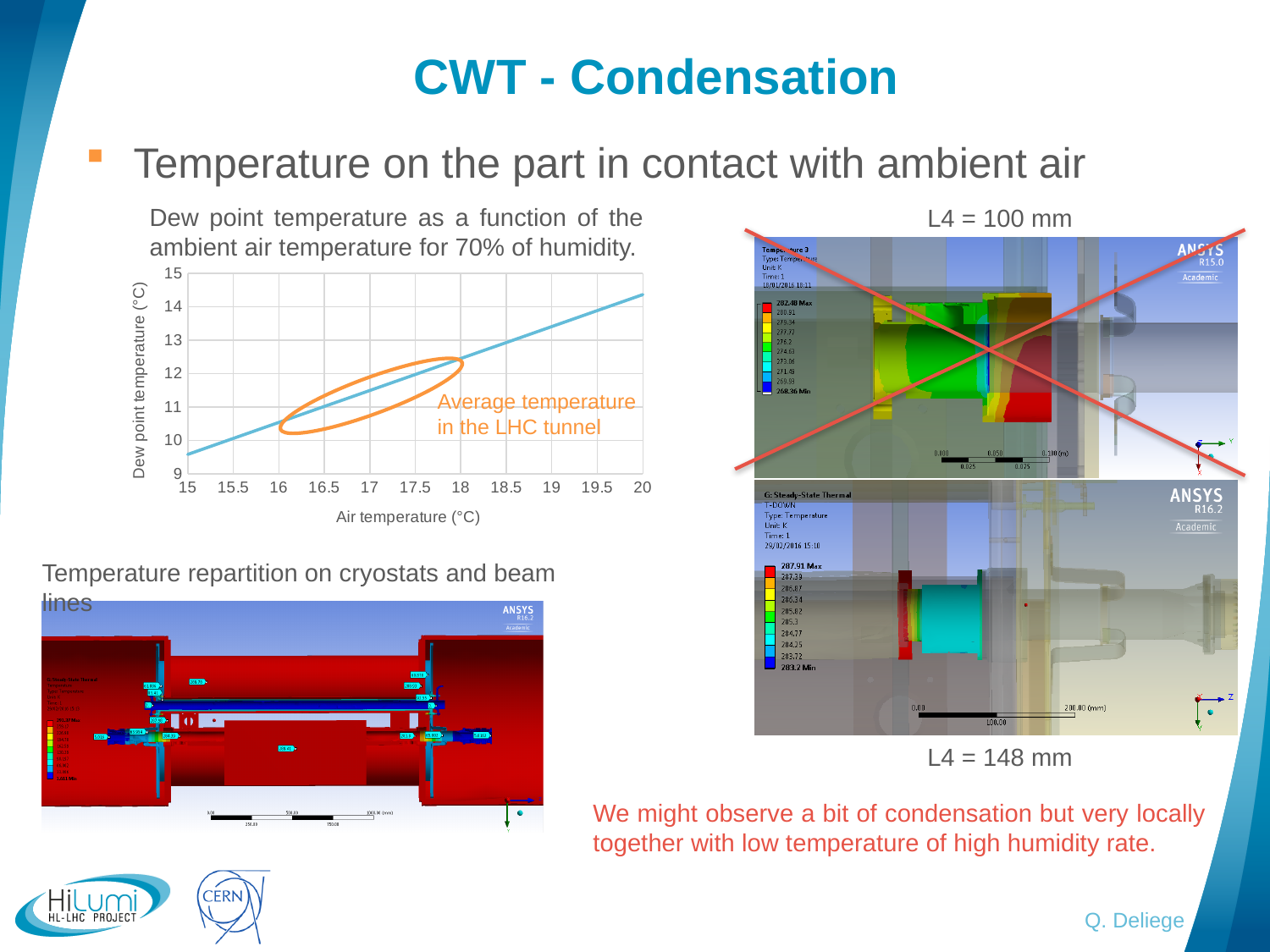
In the dew point temperature chart, is the dew point temperature at an air temperature of 18 °C greater or less than 12? greater In the dew point temperature chart, is the dew point temperature at an air temperature of 20 °C greater or less than 14? greater In the dew point temperature chart, is the dew point temperature at an air temperature of 16 °C greater or less than 10? greater What is the label of the x axis of the dew point temperature chart? Air temperature (°C) What is the label of the y axis of the dew point temperature chart? Dew point temperature (°C) How many lines are plotted in the dew point temperature chart? 1 In the dew point temperature chart, does the dew point temperature rise or fall as the air temperature increases? rise What kind of chart is the dew point temperature chart? line chart